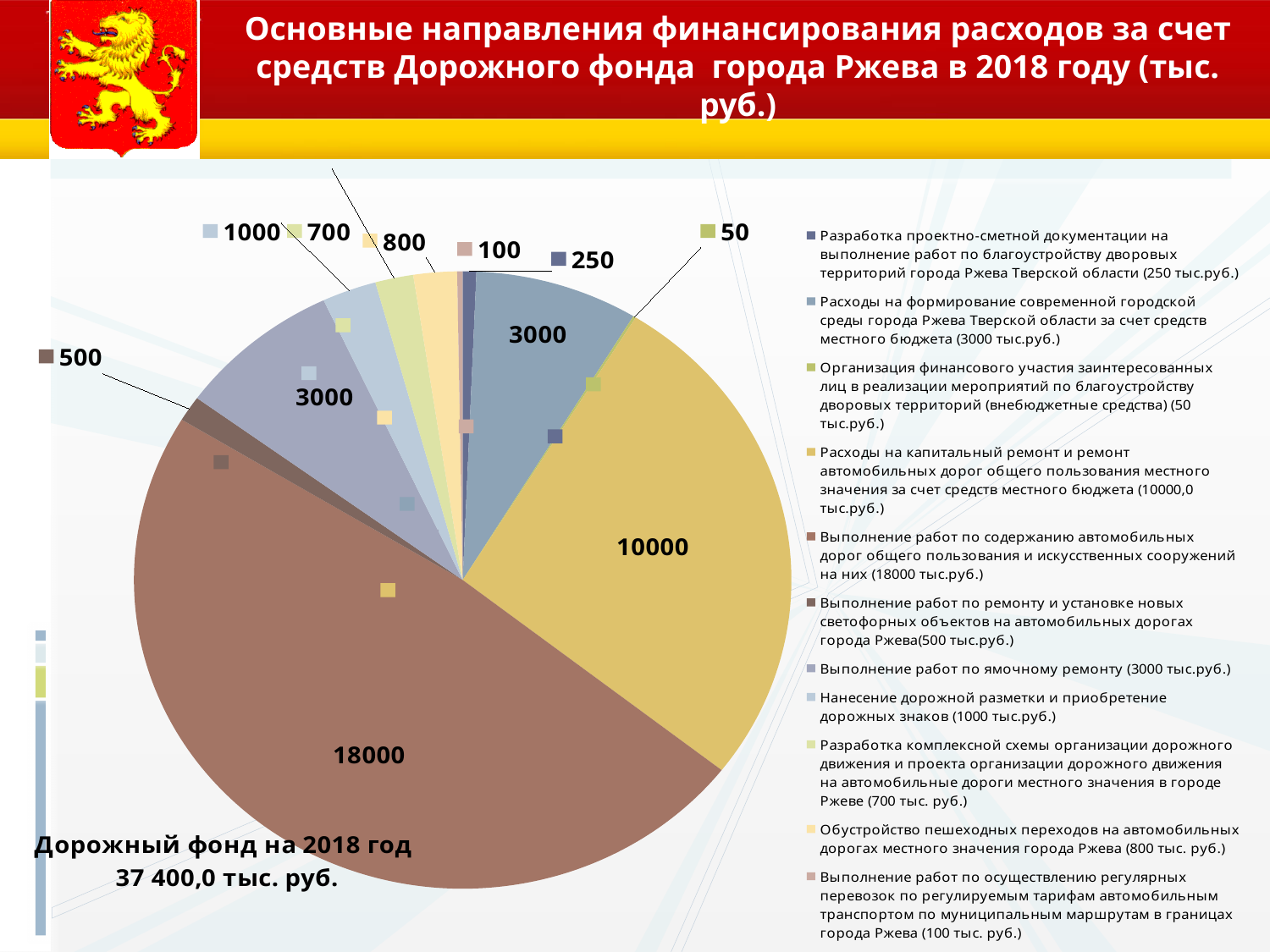
What kind of chart is shown on the slide? pie chart What is the difference between the largest slice (18000) and the slice for capital road repair (10000)? 8000 What is the value for 'Нанесение дорожной разметки и приобретение дорожных знаков'? 1000 Which is larger: the value for 'Обустройство пешеходных переходов' or the value for 'Разработка комплексной схемы организации дорожного движения'? Обустройство пешеходных переходов (800) Which category has the largest slice of the pie chart? Выполнение работ по содержанию автомобильных дорог общего пользования и искусственных сооружений на них What is the value for 'Выполнение работ по ремонту и установке новых светофорных объектов на автомобильных дорогах города Ржева'? 500 How many slices does the pie chart have? 11 What is the value of the smallest slice of the pie chart? 50 What is the value of the largest slice of the pie chart? 18000 Which category has the smallest slice of the pie chart? Организация финансового участия заинтересованных лиц в реализации мероприятий по благоустройству дворовых территорий (внебюджетные средства) What is the value for 'Расходы на капитальный ремонт и ремонт автомобильных дорог общего пользования местного значения за счет средств местного бюджета'? 10000 What total amount of the road fund for 2018 is stated on the slide? 37 400,0 тыс. руб.